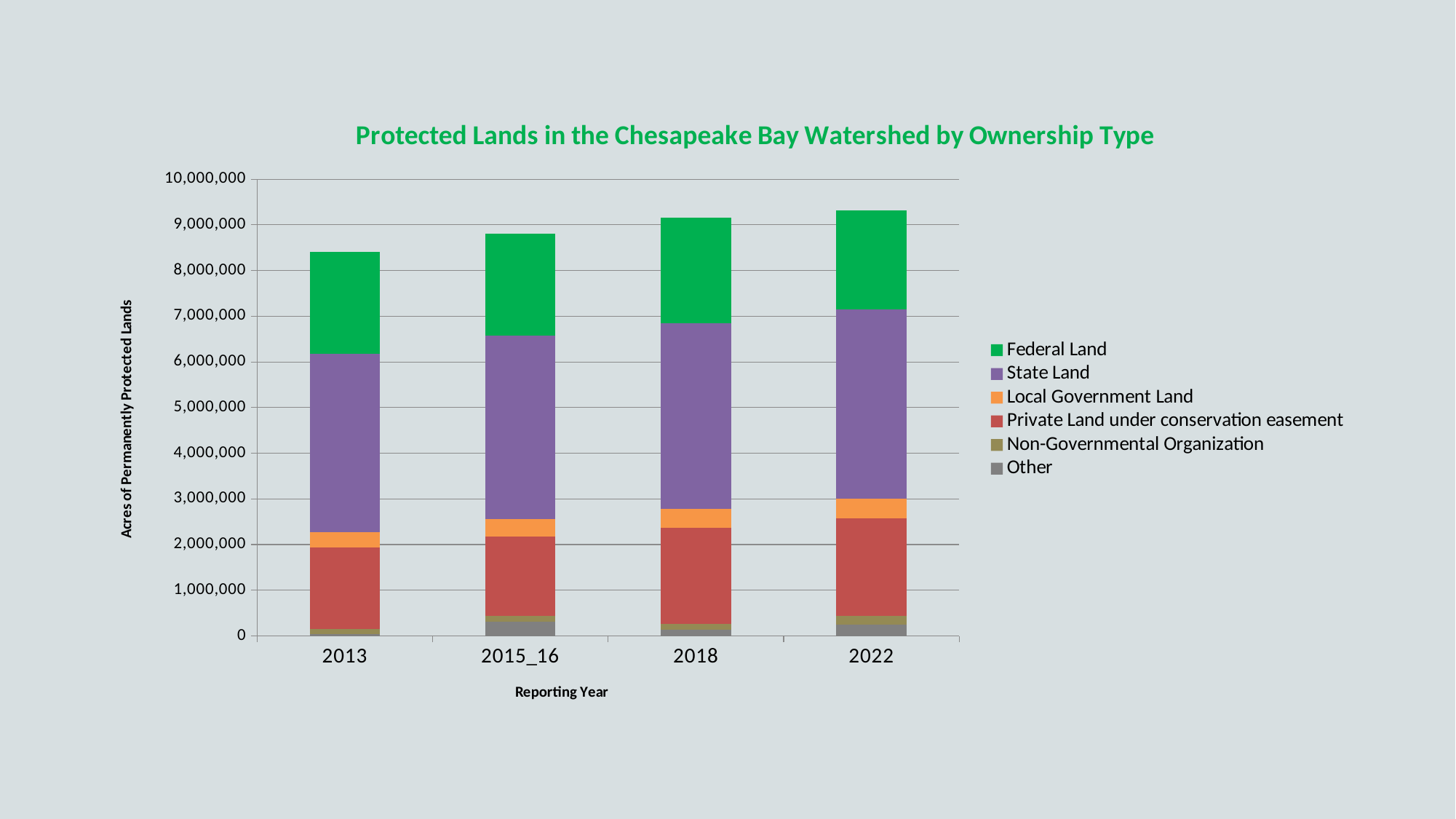
Is the total for 2022 greater or less than 9,000,000 acres? greater Which reporting year has the lowest total acres of permanently protected lands? 2013 What is the title of the chart? Protected Lands in the Chesapeake Bay Watershed by Ownership Type What kind of chart is shown on the slide? Stacked bar chart Is the total for 2015_16 greater or less than 9,000,000 acres? less Which ownership type makes up the largest segment of the 2022 bar? State Land How many reporting years are shown on the x axis? 4 Is the total for 2013 greater or less than 9,000,000 acres? less Which reporting year has the highest total acres of permanently protected lands? 2022 Which is larger, the total protected acres in 2013 or in 2022? 2022 Do the total acres of permanently protected lands rise or fall from 2013 to 2022? rise How many ownership types does the legend list? 6